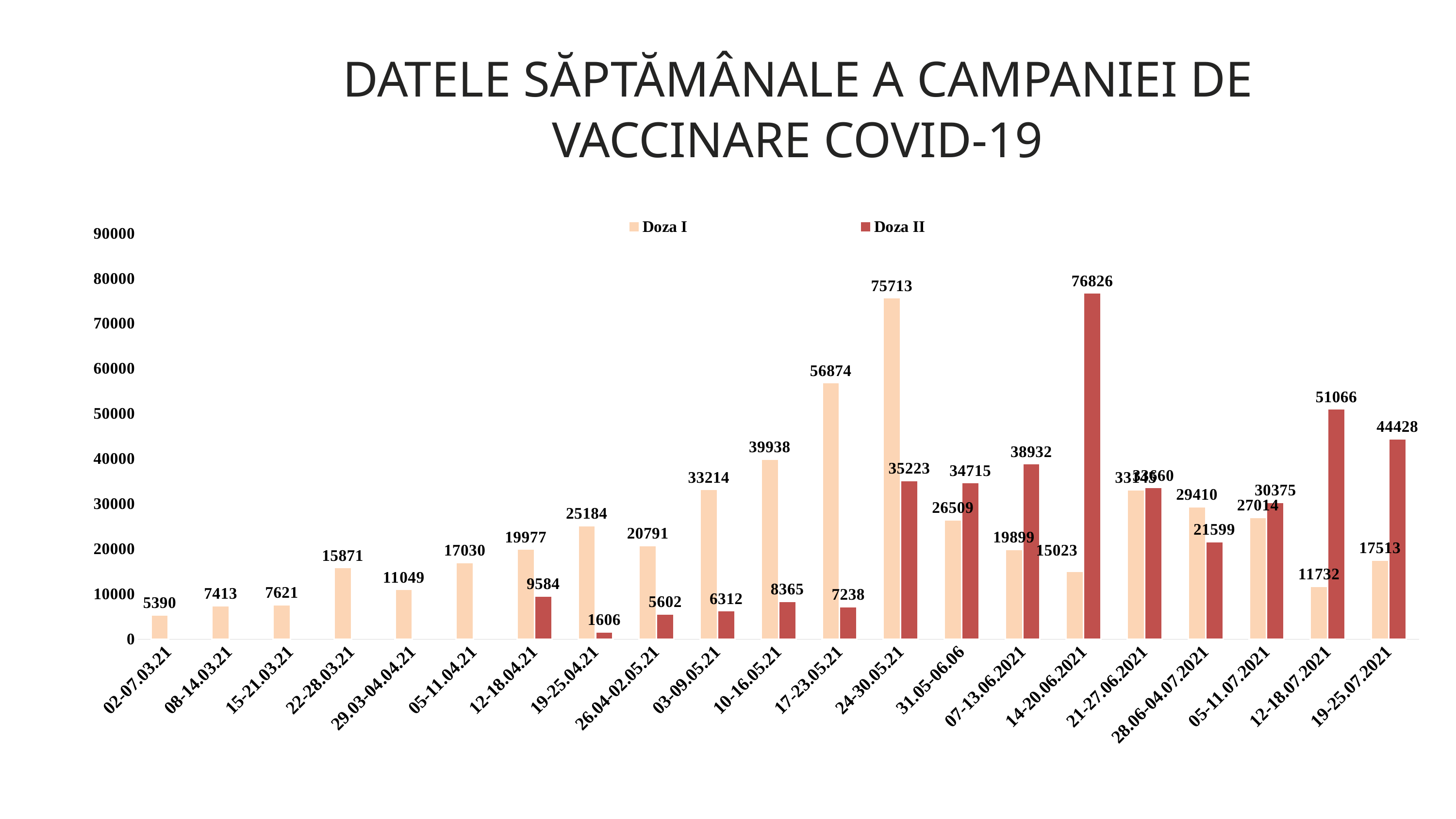
Which week has the highest Doza I value? 24-30.05.21 Which week has the highest Doza II value? 14-20.06.2021 What is the Doza I value for the week 24-30.05.21? 75713 How many series does the legend list? 2 For the week 12-18.04.21, which is larger, Doza I or Doza II? Doza I What is the difference between Doza II and Doza I for the week 12-18.07.2021? 39334 What is the Doza II value for the week 19-25.04.21? 1606 Is the Doza II value for the week 19-25.07.2021 greater or less than 40000? greater What is the Doza II value for the week 14-20.06.2021? 76826 How many weeks are shown on the x axis? 21 What is the difference between Doza I and Doza II for the week 24-30.05.21? 40490 Which week has the lowest Doza I value? 02-07.03.21